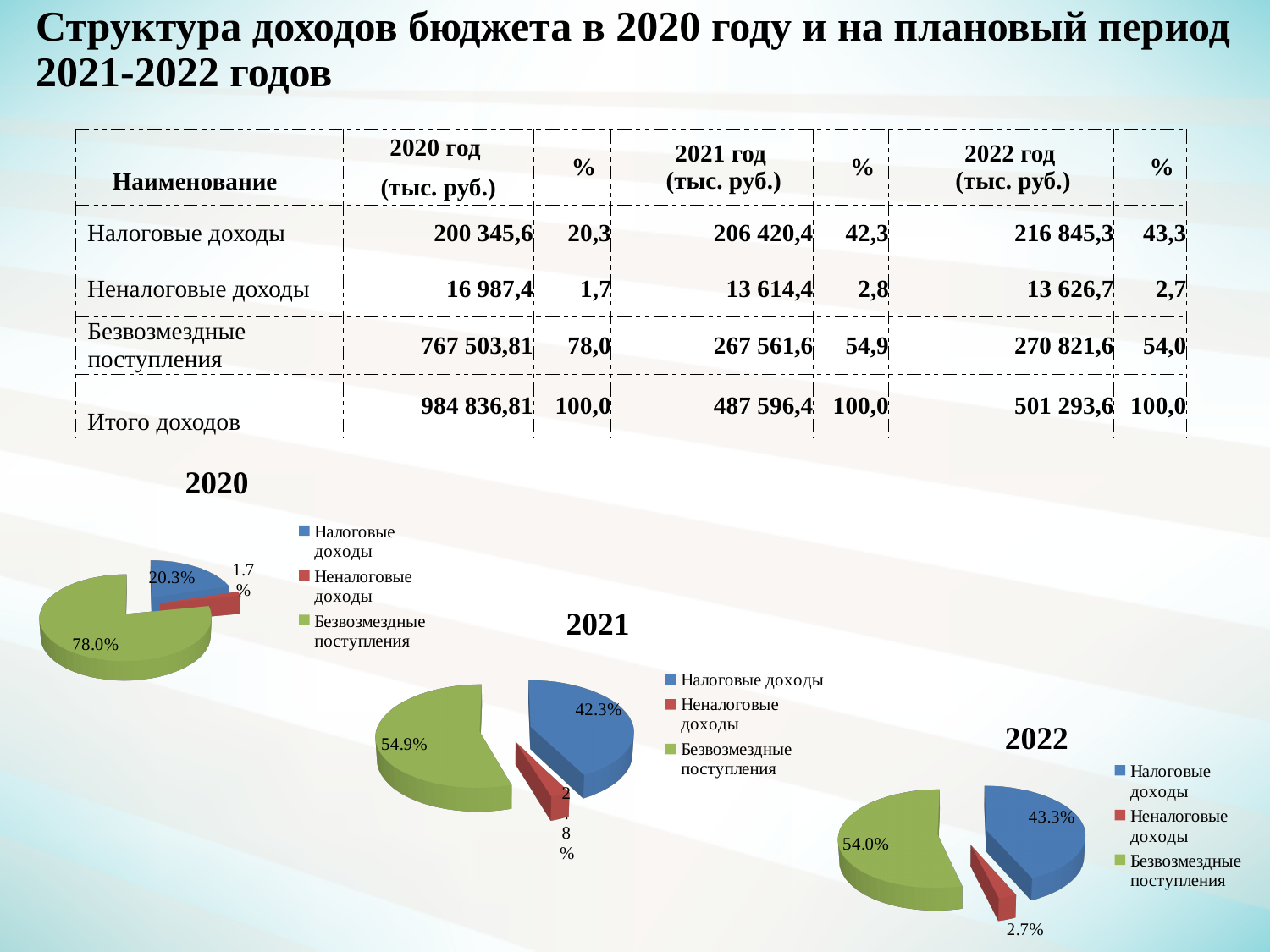
In the 2022 pie chart, what share is shown for Неналоговые доходы? 2.7% In the 2022 pie chart, which is larger, Налоговые доходы or Безвозмездные поступления? Безвозмездные поступления In the 2020 pie chart, what share is shown for Безвозмездные поступления? 78.0% How many categories does the legend of the 2021 chart list? 3 In the 2022 pie chart, what share is shown for Налоговые доходы? 43.3% In the 2020 pie chart, which category has the largest slice? Безвозмездные поступления In the 2021 pie chart, which category has the smallest slice? Неналоговые доходы What type of chart is the 2022 chart? Pie chart